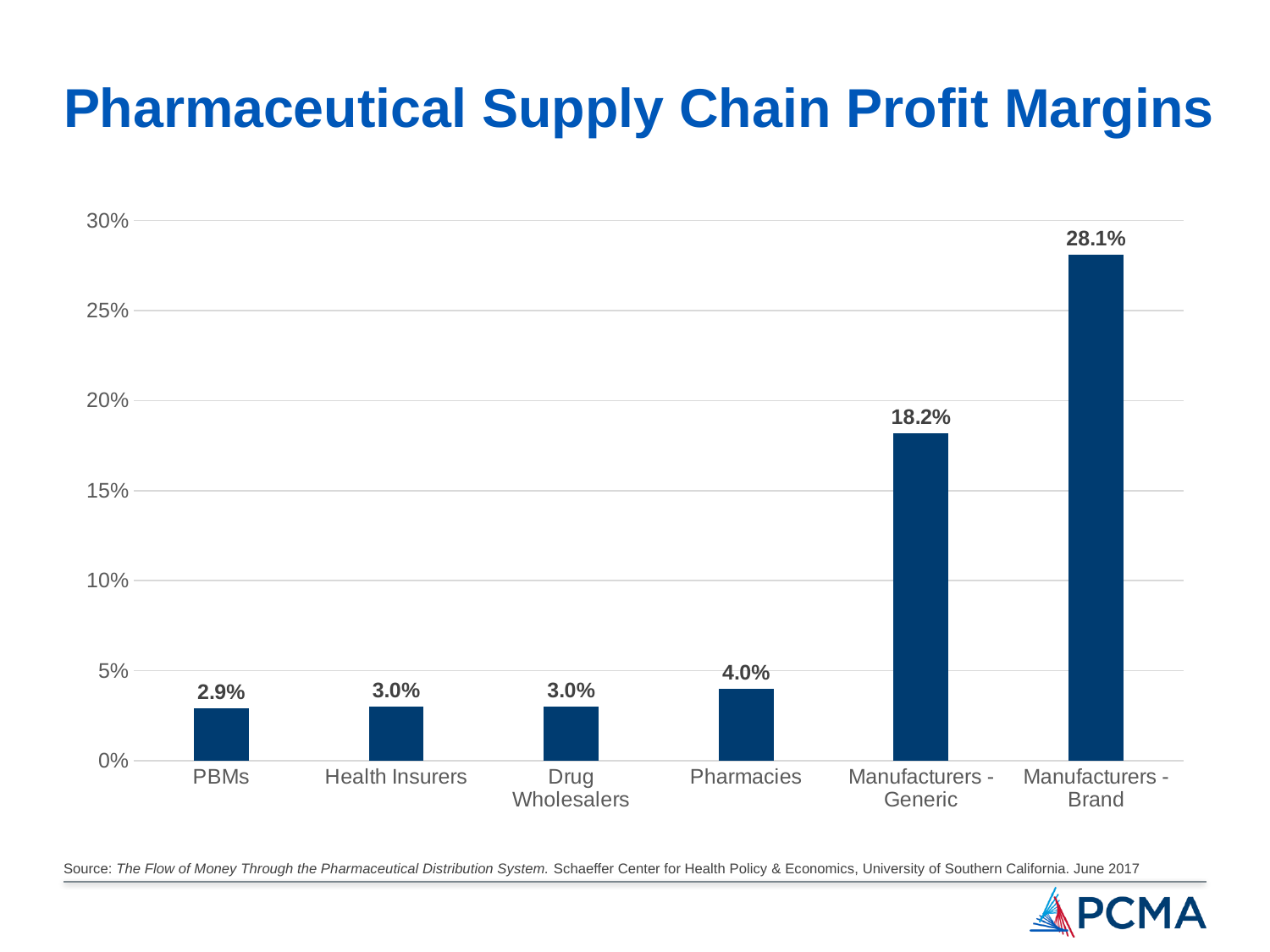
Which category has the lowest profit margin? PBMs What is the difference in profit margin between Pharmacies and PBMs? 1.1% Which category has the highest profit margin? Manufacturers - Brand What is the profit margin for PBMs? 2.9% Is the profit margin for Manufacturers - Brand greater or less than 25%? greater What kind of chart is shown on the slide? Bar chart What is the difference in profit margin between Manufacturers - Brand and Manufacturers - Generic? 9.9% How many categories are shown on the chart? 6 What is the title of the chart? Pharmaceutical Supply Chain Profit Margins What is the profit margin for Manufacturers - Generic? 18.2% What is the profit margin for Pharmacies? 4.0% Which has a larger profit margin, Pharmacies or Health Insurers? Pharmacies